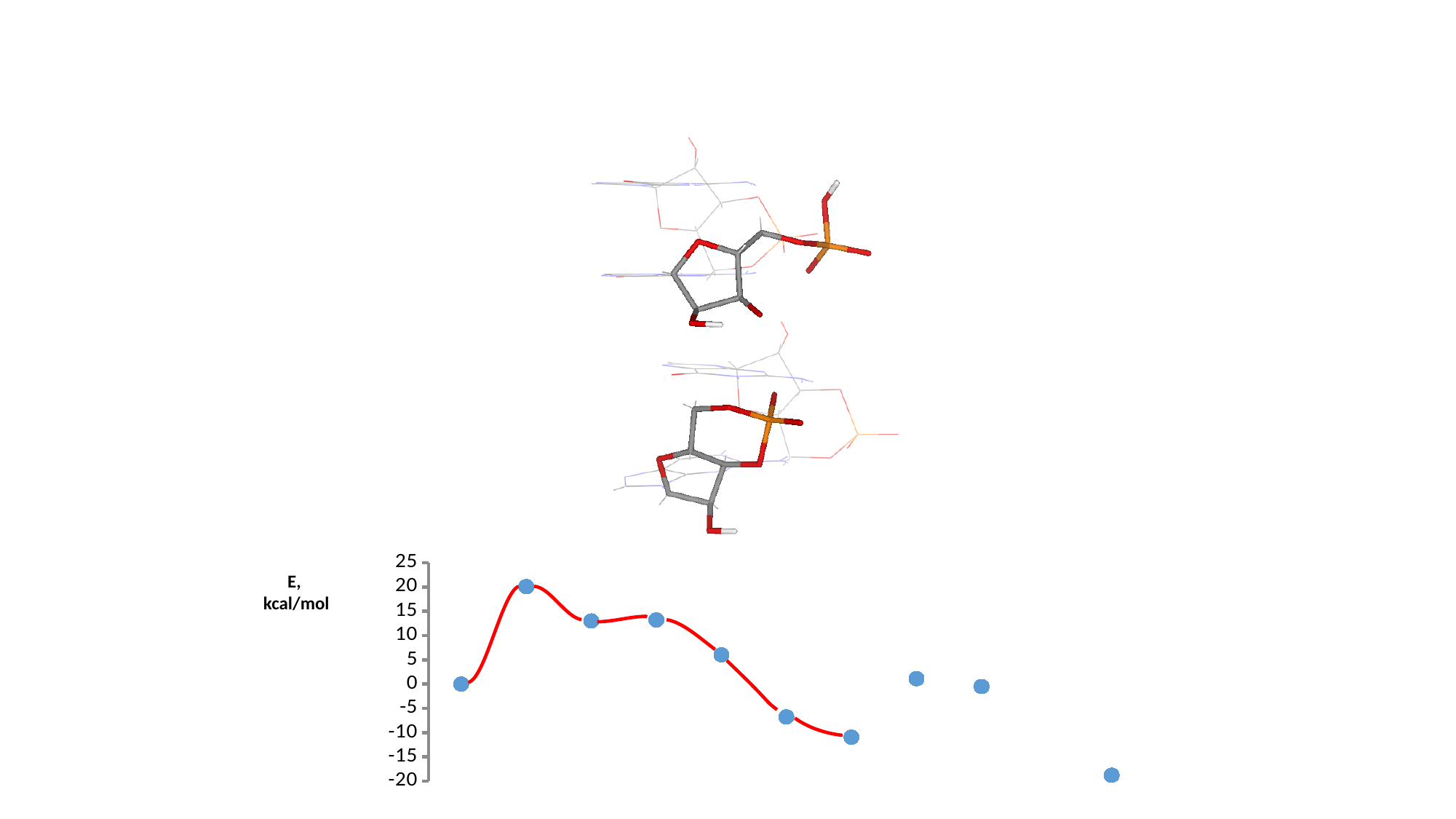
Is the value of the fifth point from the left greater or less than 10? less What is the label of the vertical axis? E, kcal/mol What are the minimum and maximum values shown on the vertical axis? -20 and 25 Is the value of the lowest point on the chart greater or less than -15? less Is the value of the seventh point from the left (the end of the red curve) greater or less than -5? less Which is larger: the value of the second point from the left or the value of the third point from the left? the second point from the left What kind of chart is shown on the slide? scatter chart Which point has the lowest value on the chart? the rightmost point How many data points are plotted on the chart? 10 Do the values rise or fall from the second point to the seventh point along the red curve? fall Which point is the highest on the chart: the second point from the left or the rightmost point? the second point from the left